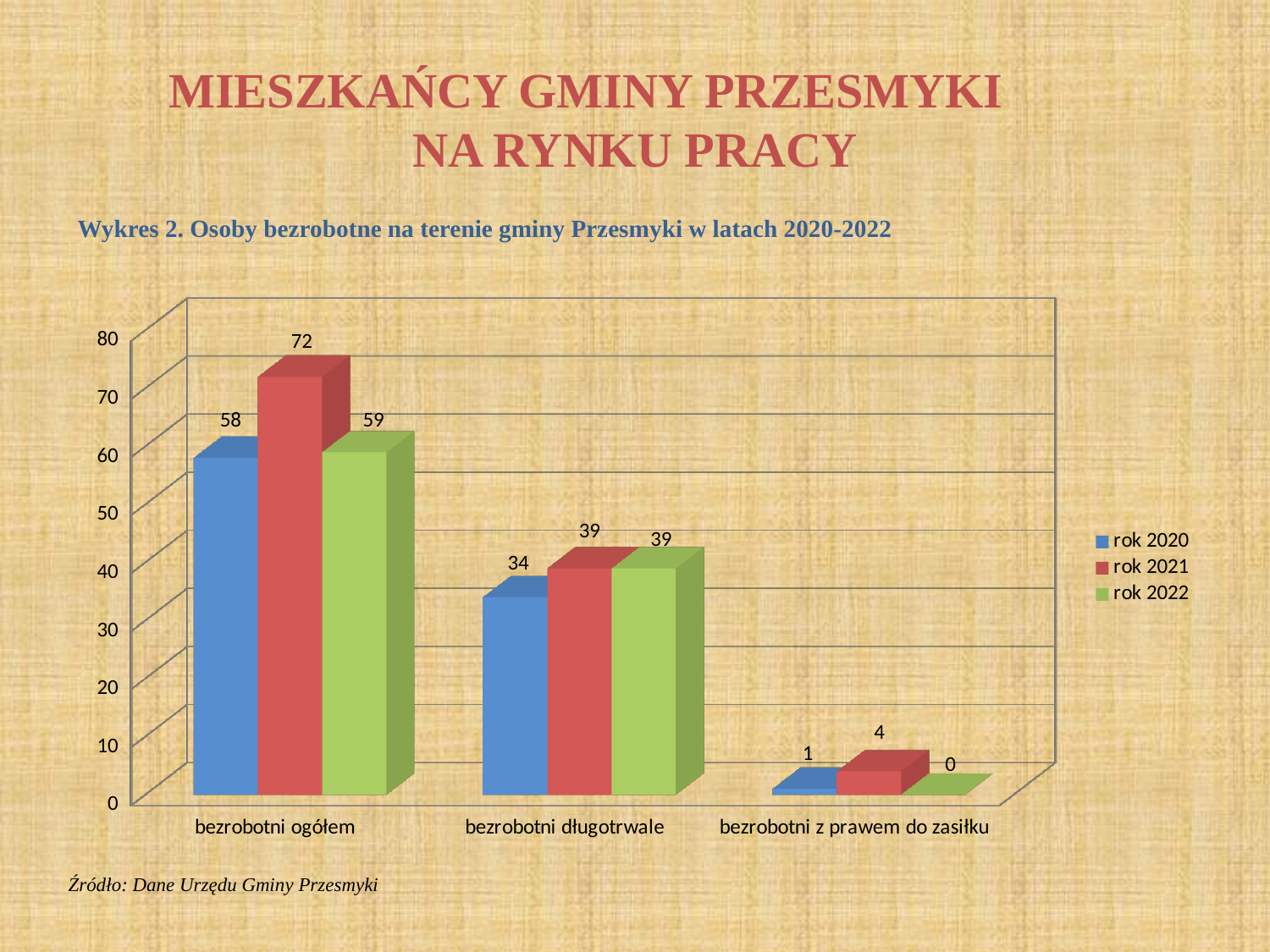
What is the value for 'bezrobotni ogółem' in the 'rok 2021' series? 72 What is the value for 'bezrobotni długotrwale' in the 'rok 2020' series? 34 What is the difference between the 'rok 2021' and 'rok 2020' values for 'bezrobotni z prawem do zasiłku'? 3 What is the title of the chart? Wykres 2. Osoby bezrobotne na terenie gminy Przesmyki w latach 2020-2022 How many categories are shown on the x axis? 3 Which category has the lowest value in the 'rok 2021' series? bezrobotni z prawem do zasiłku Which category has the highest value in the 'rok 2020' series? bezrobotni ogółem Which is larger for 'bezrobotni ogółem': the 'rok 2020' value or the 'rok 2022' value? rok 2022 How many series does the legend list? 3 What is the difference between the 'rok 2021' and 'rok 2020' values for 'bezrobotni ogółem'? 14 What kind of chart is shown on the slide? bar chart What is the value for 'bezrobotni z prawem do zasiłku' in the 'rok 2022' series? 0